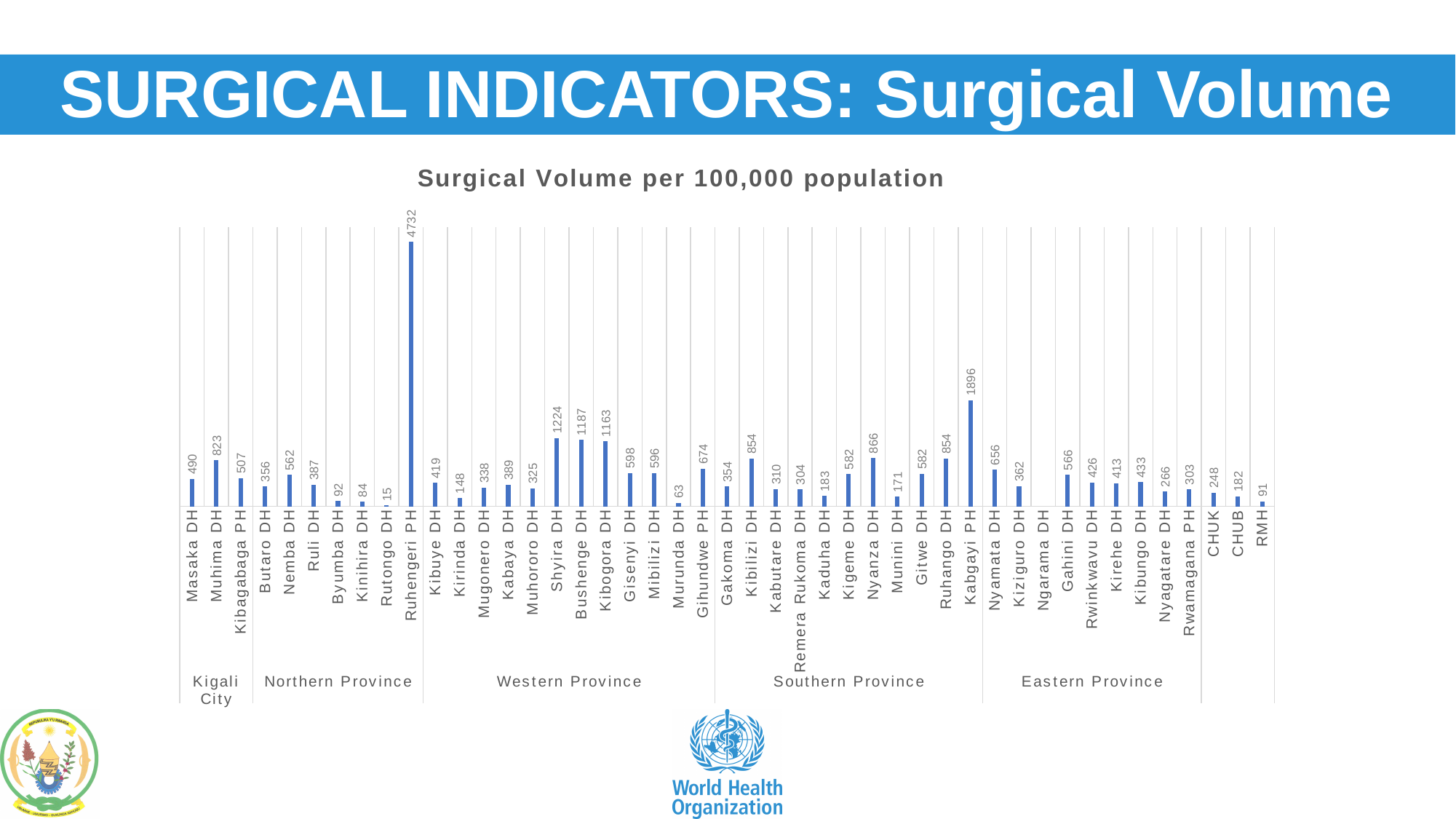
Which has a higher surgical volume per 100,000 population, Shyira DH or Bushenge DH? Shyira DH What is the title of the chart? Surgical Volume per 100,000 population Which hospital has the highest surgical volume per 100,000 population? Ruhengeri PH What is the surgical volume per 100,000 population for Nyanza DH? 866 What is the difference between the values for Kabgayi PH and Kibilizi DH? 1042 What kind of chart is shown on the slide? Bar chart What is the difference between the values for Muhima DH and Masaka DH? 333 What is the surgical volume per 100,000 population for CHUK? 248 What is the surgical volume per 100,000 population for Kabgayi PH? 1896 Among the Northern Province hospitals, which has the lowest surgical volume per 100,000 population? Rutongo DH What is the surgical volume per 100,000 population for Ruhengeri PH? 4732 How many hospitals are listed under Kigali City? 3